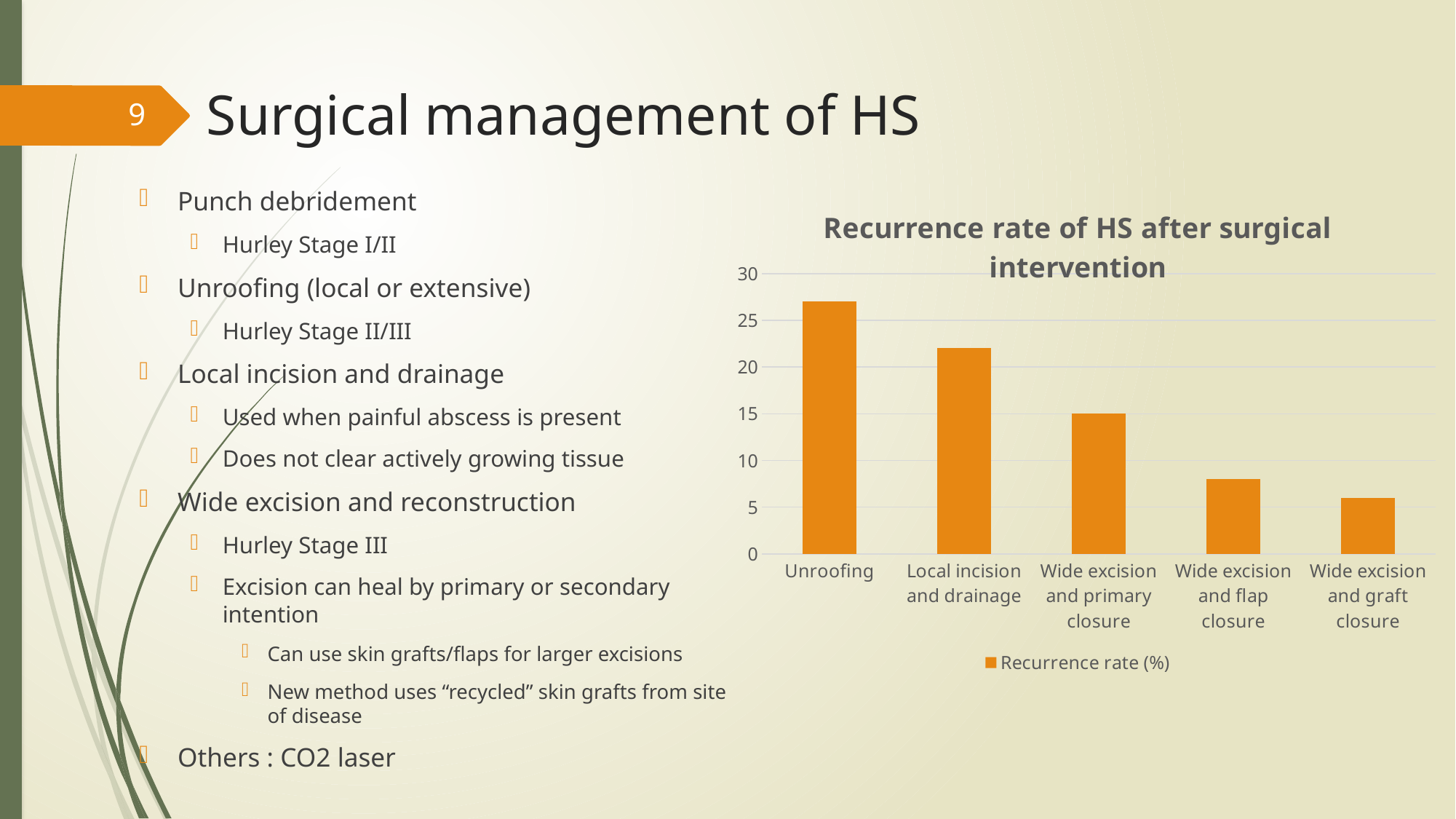
What type of chart is shown on the slide? Bar chart How many surgical interventions are shown on the x axis of the chart? 5 Which has a higher recurrence rate, Unroofing or Wide excision and primary closure? Unroofing What is the title of the chart? Recurrence rate of HS after surgical intervention Which surgical intervention has the highest recurrence rate in the chart? Unroofing What is the legend entry for the series in the chart? Recurrence rate (%) Do the recurrence rates rise or fall moving from left to right along the x axis? Fall Which surgical intervention has the lowest recurrence rate in the chart? Wide excision and graft closure Is the recurrence rate for Wide excision and flap closure greater or less than 10? less How many series does the chart legend list? 1 Is the recurrence rate for Unroofing greater or less than 25? greater Is the recurrence rate for Local incision and drainage greater or less than 20? greater